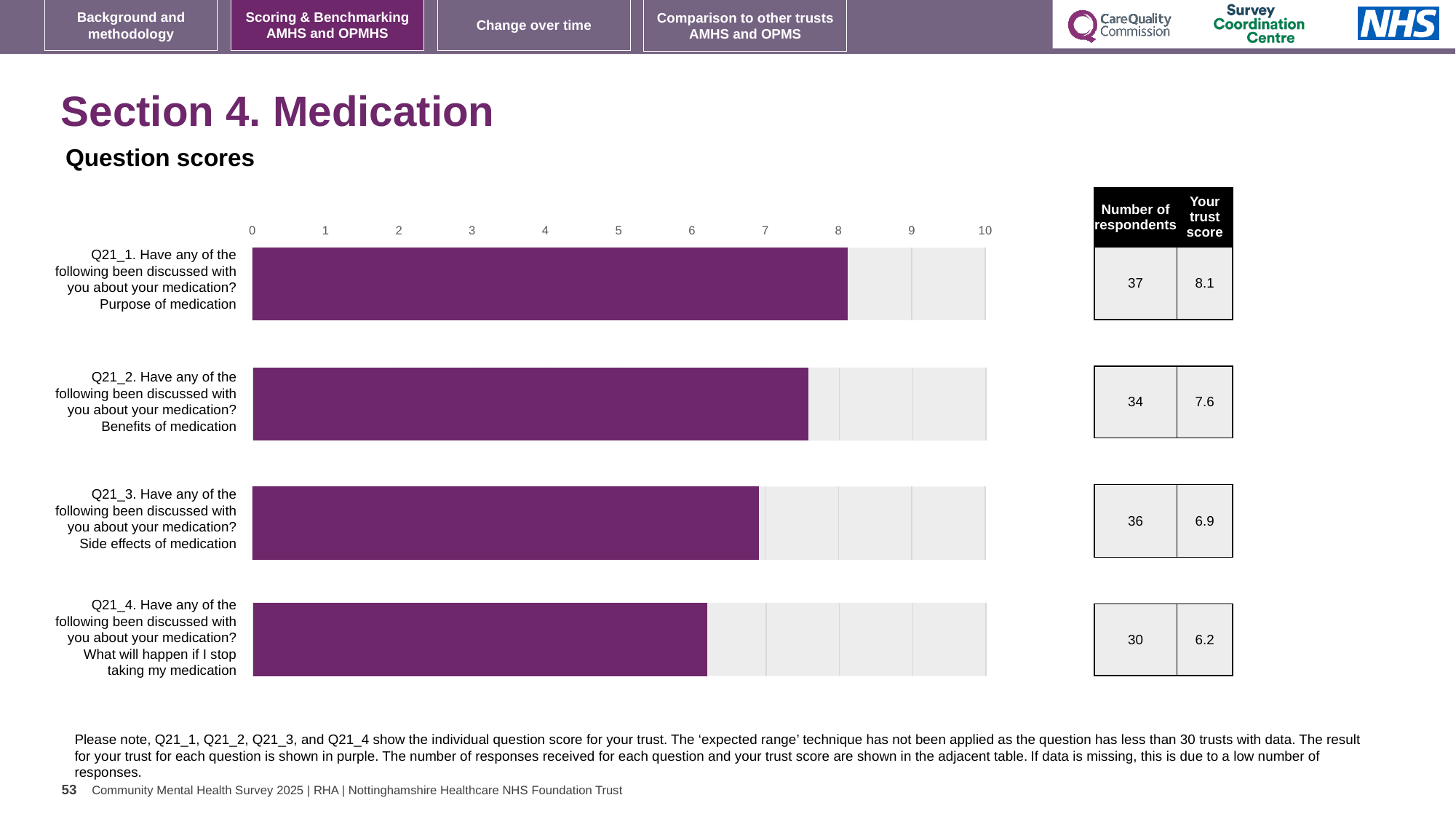
What is the trust score for Q21_3 (Side effects of medication)? 6.9 What colour are the bars showing the trust's results? Purple What is the maximum value shown on the chart's axis? 10 Which question has the lowest trust score? Q21_4. What will happen if I stop taking my medication What type of chart is shown on the slide? Bar chart How many questions are plotted in the chart? 4 How many respondents answered Q21_4 (What will happen if I stop taking my medication)? 30 What is the trust score for Q21_1 (Purpose of medication)? 8.1 Is the trust score for Q21_2 (Benefits of medication) greater or less than 7? greater Which has a higher trust score, Q21_2 (Benefits of medication) or Q21_3 (Side effects of medication)? Q21_2. Benefits of medication What is the difference between the trust scores for Q21_1 (Purpose of medication) and Q21_4 (What will happen if I stop taking my medication)? 1.9 Which question has the highest trust score? Q21_1. Purpose of medication